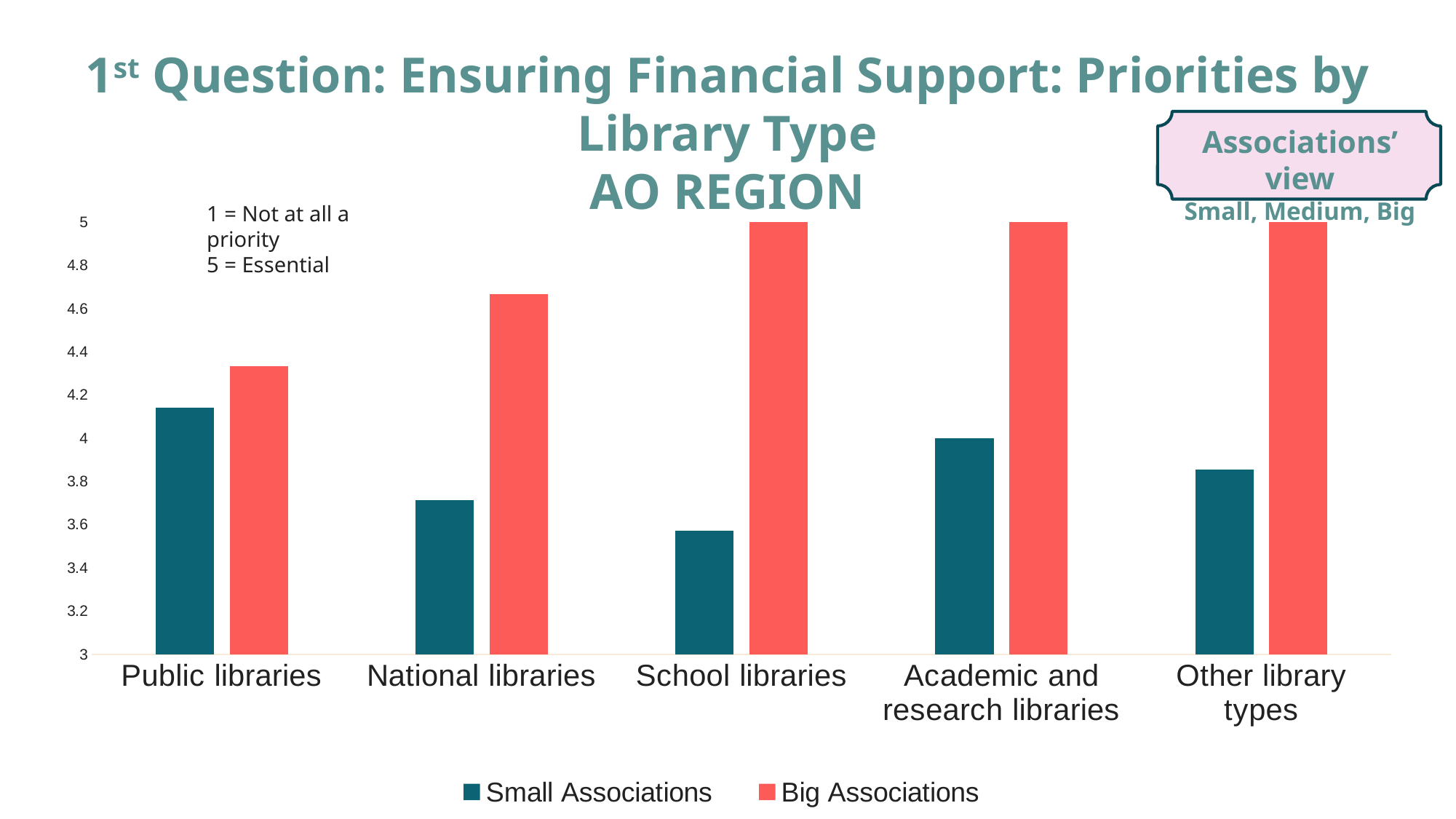
For Public libraries, which is larger: Small Associations or Big Associations? Big Associations How many library types are shown on the x axis? 5 What kind of chart is shown on the slide? bar chart Which library type has the lowest value for Small Associations? School libraries Is the value for Big Associations for Public libraries greater or less than 4.2? greater What is the value for Big Associations for School libraries? 5 Which colour represents Big Associations in the legend? red Which library type has the lowest value for Big Associations? Public libraries What is the value for Small Associations for Academic and research libraries? 4 Is the value for Small Associations for National libraries greater or less than 3.8? less Which library type has the highest value for Small Associations? Public libraries How many series does the legend list? 2